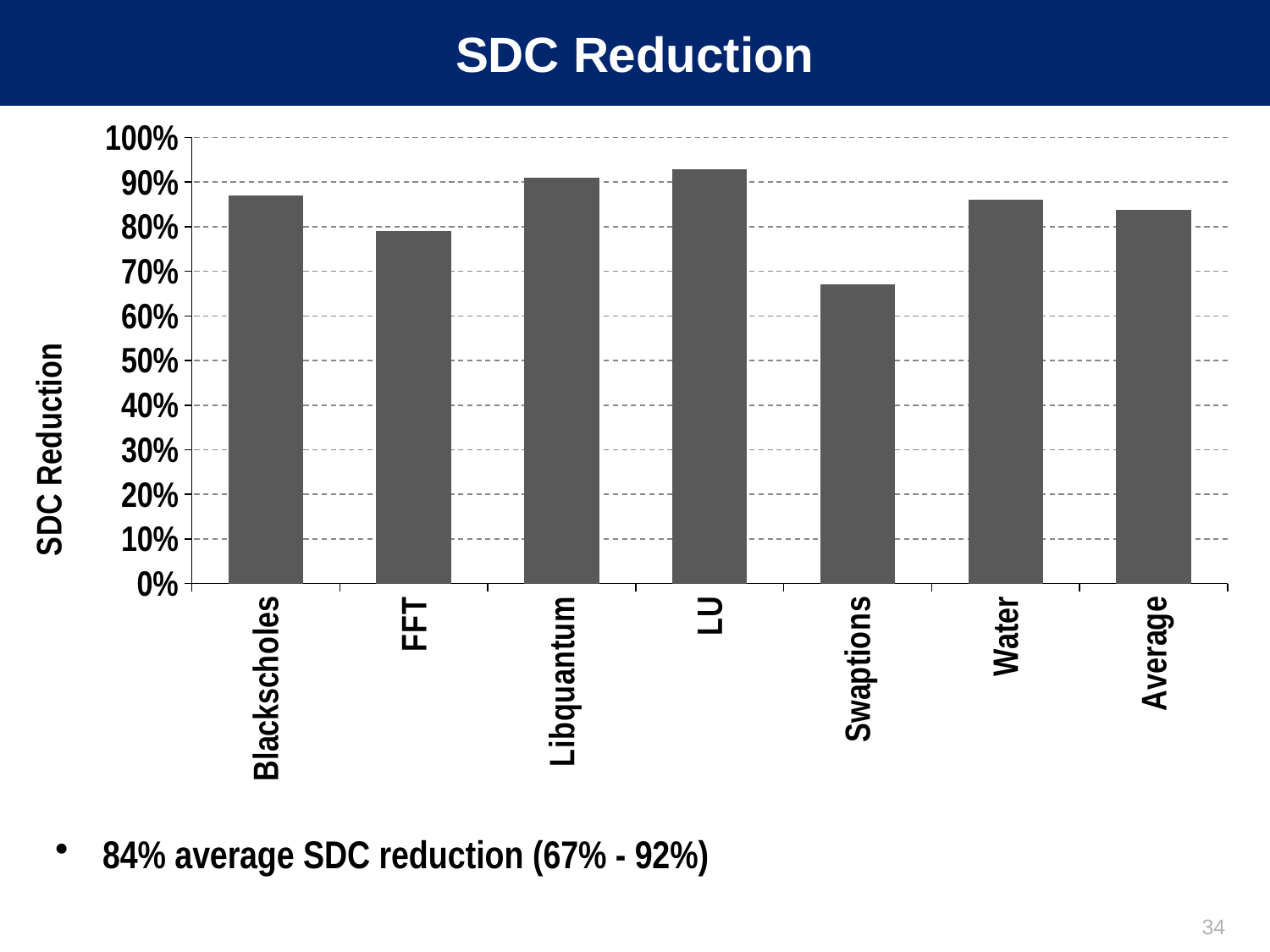
What kind of chart is shown on the slide? bar chart Is the value for LU greater or less than 90%? greater What is the label on the vertical axis of the chart? SDC Reduction Is the value for Water greater or less than 90%? less Which has a higher SDC reduction, Libquantum or Water? Libquantum How many categories are plotted along the x axis? 7 Which has a higher SDC reduction, Blackscholes or FFT? Blackscholes Is the value for Blackscholes greater or less than 80%? greater Which category has the lowest SDC reduction? Swaptions Which category has the highest SDC reduction? LU